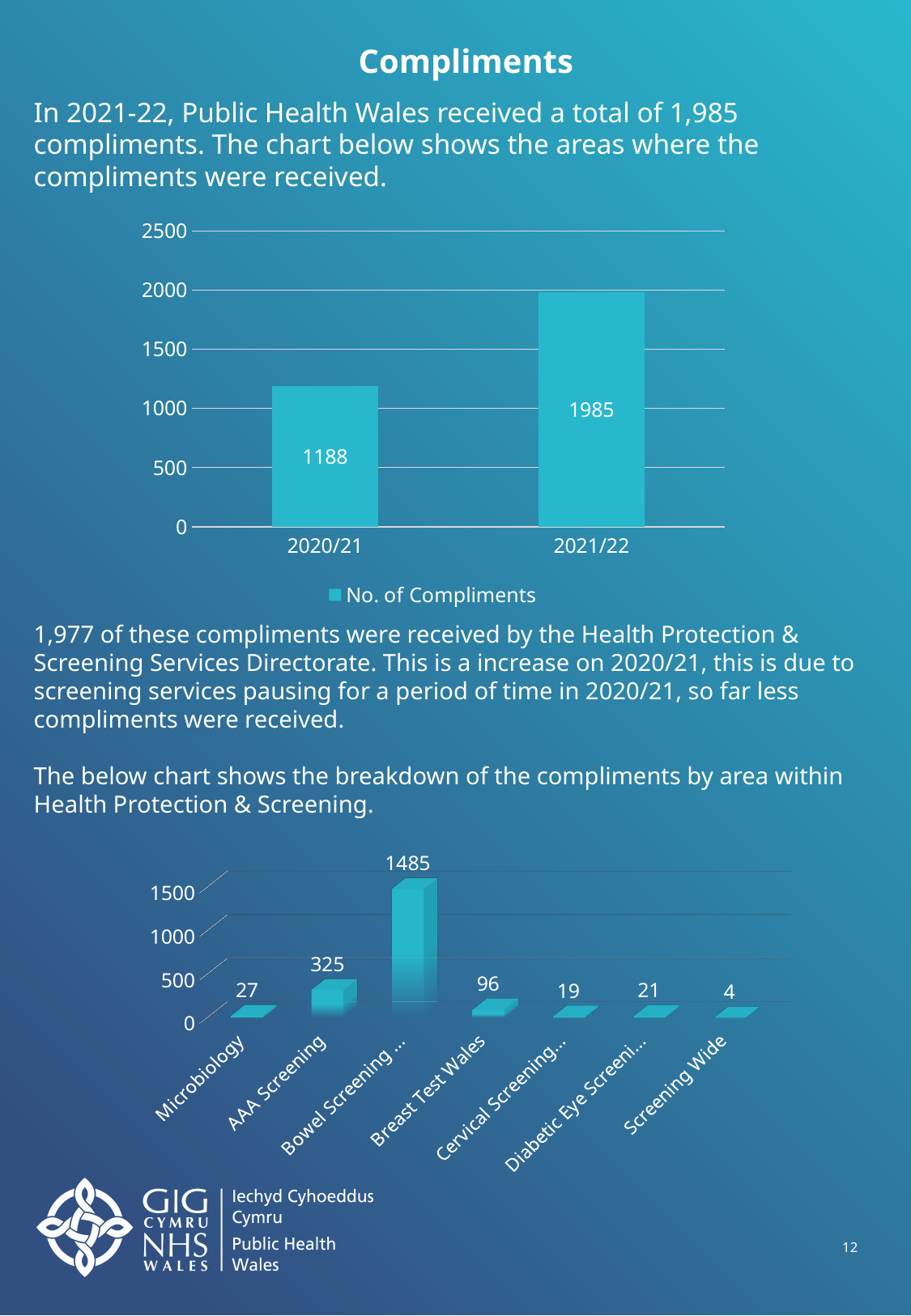
In the bottom chart, which area received the most compliments? Bowel Screening What type of chart is the top chart? Bar chart In the bottom chart, how many areas are shown? 7 In the top chart, by how much did the number of compliments increase from 2020/21 to 2021/22? 797 In the bottom chart, which received more compliments, Microbiology or Breast Test Wales? Breast Test Wales In the top chart, what was the number of compliments in 2021/22? 1985 In the bottom chart, how many compliments did AAA Screening receive? 325 In the bottom chart, how many compliments did Breast Test Wales receive? 96 In the top chart, what was the number of compliments in 2020/21? 1188 In the bottom chart, which area received the fewest compliments? Screening Wide In the top chart, how many categories are shown on the x axis? 2 In the top chart, what series name does the legend show? No. of Compliments